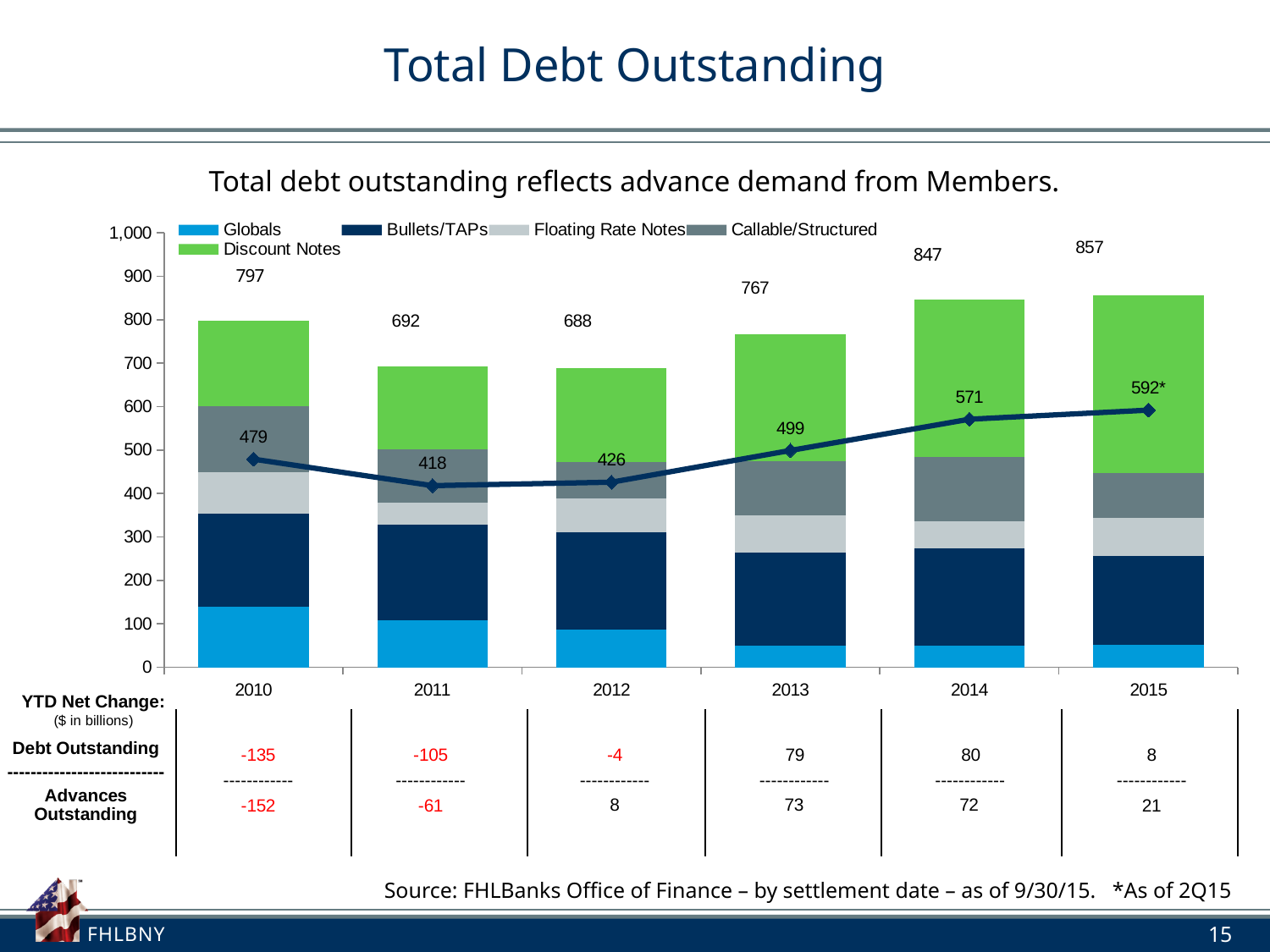
Does the line series rise or fall from 2012 to 2015? Rise What value does the line series show for 2015? 592* What value does the line series show for 2013? 499 Which year has the larger total debt outstanding, 2011 or 2012? 2011 What is the total debt outstanding shown for 2010? 797 How many years are shown on the x axis of the chart? 6 How many series does the chart legend list? 5 Which year has the highest total debt outstanding? 2015 Which year has the lowest total debt outstanding? 2012 What is the difference between the total debt outstanding in 2010 and in 2011? 105 What kind of chart is used to show the debt components? Stacked bar chart What is the difference between the total debt outstanding in 2015 and in 2014? 10